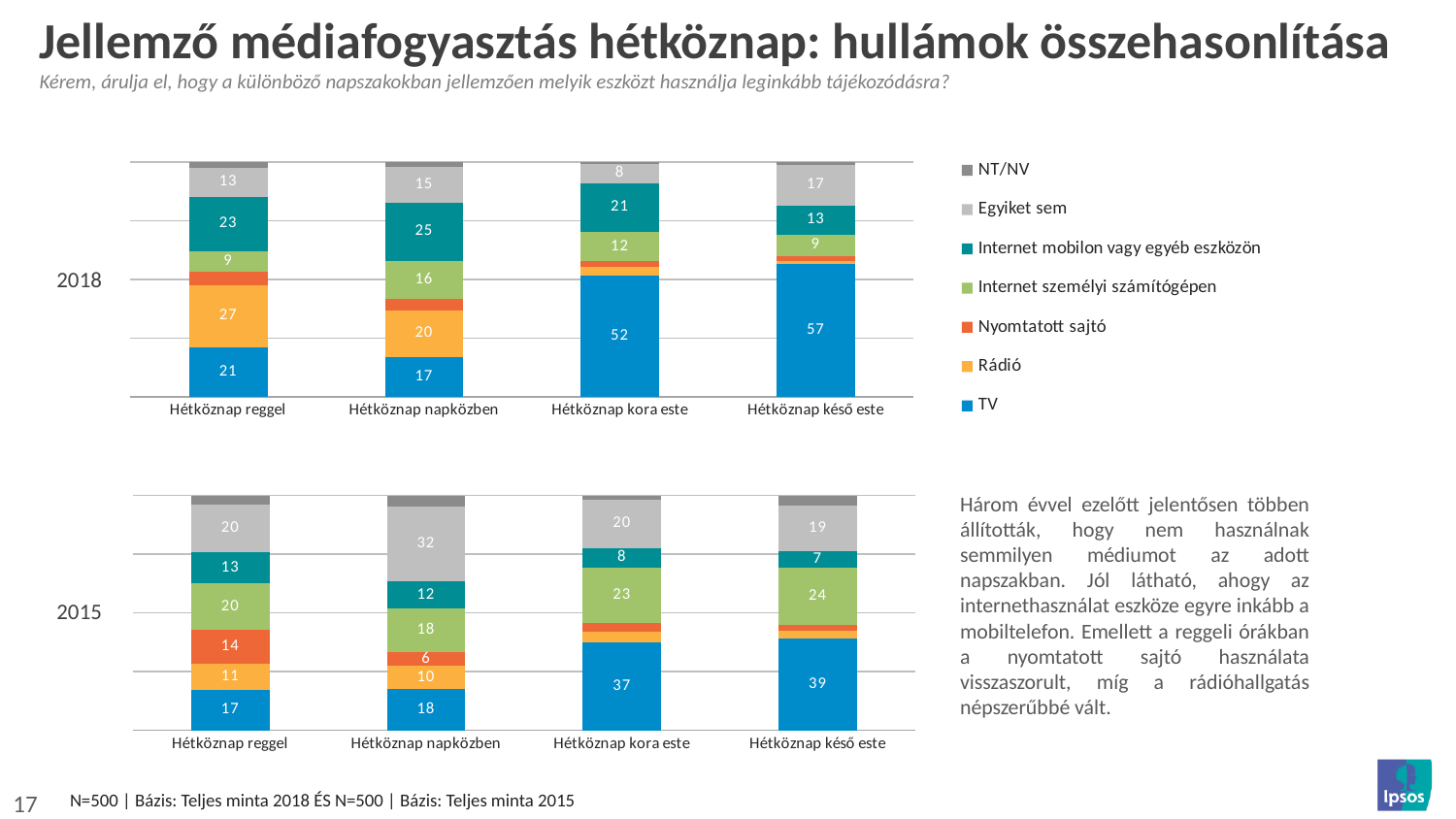
How many categories are shown on the x axis of the 2015 chart? 4 In the 2018 chart, what is the Rádió value for Hétköznap reggel? 27 In the 2015 chart, what is the Egyiket sem value for Hétköznap napközben? 32 What type of chart is the 2018 chart? Stacked bar chart In the 2015 chart, what is the Nyomtatott sajtó value for Hétköznap reggel? 14 In the 2015 chart, which category has the lowest Internet mobilon vagy egyéb eszközön value? Hétköznap késő este In the 2018 chart, which is larger: the Internet mobilon vagy egyéb eszközön value for Hétköznap napközben or for Hétköznap reggel? Hétköznap napközben How many series does the legend list? 7 In the 2015 chart, what is the difference between the Internet személyi számítógépen values for Hétköznap késő este and Hétköznap reggel? 4 What is the difference between the TV value for Hétköznap késő este in the 2018 chart and in the 2015 chart? 18 In the 2018 chart, which category has the highest TV value? Hétköznap késő este In the 2018 chart, what is the TV value for Hétköznap késő este? 57